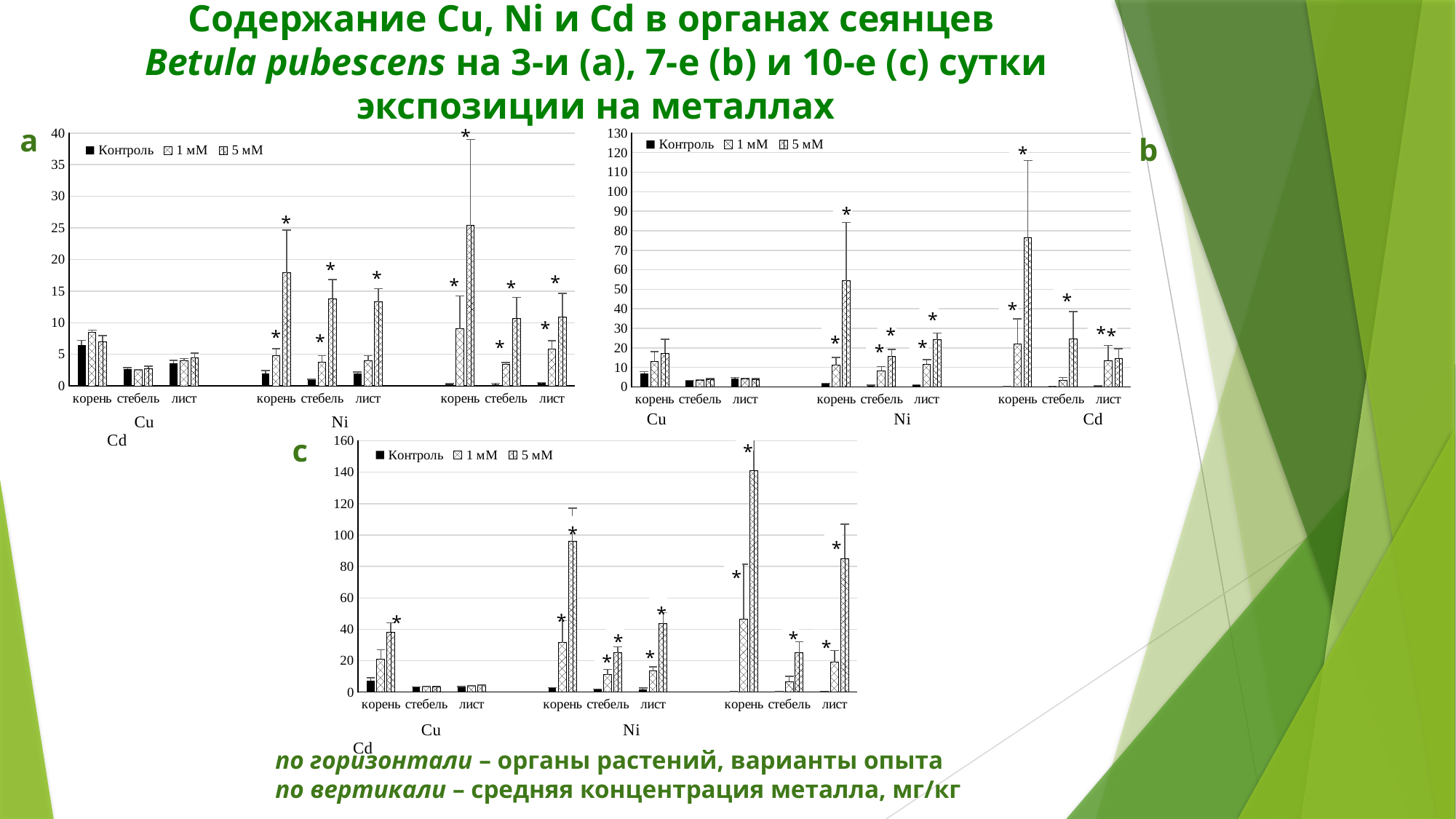
What are the three legend entries on chart c (bottom)? Контроль, 1 мМ, 5 мМ On chart c (bottom), is the 5 мМ value for Ni корень greater or less than 80? greater On chart b (top right), which is larger: the 5 мМ value for Ni корень or the 5 мМ value for Cd корень? Cd корень On chart a (top left), is the 5 мМ value for Cd корень greater or less than 20? greater On chart a (top left), is the 5 мМ value for Ni корень greater or less than 15? greater How many organ categories are labelled along the x axis of chart c (bottom)? 9 What kind of chart is chart a (top left)? bar chart What is the maximum value shown on the y axis of chart b (top right)? 130 On chart c (bottom), which organ and metal has the tallest bar? Cd корень (5 мМ) How many series does the legend of chart b (top right) list? 3